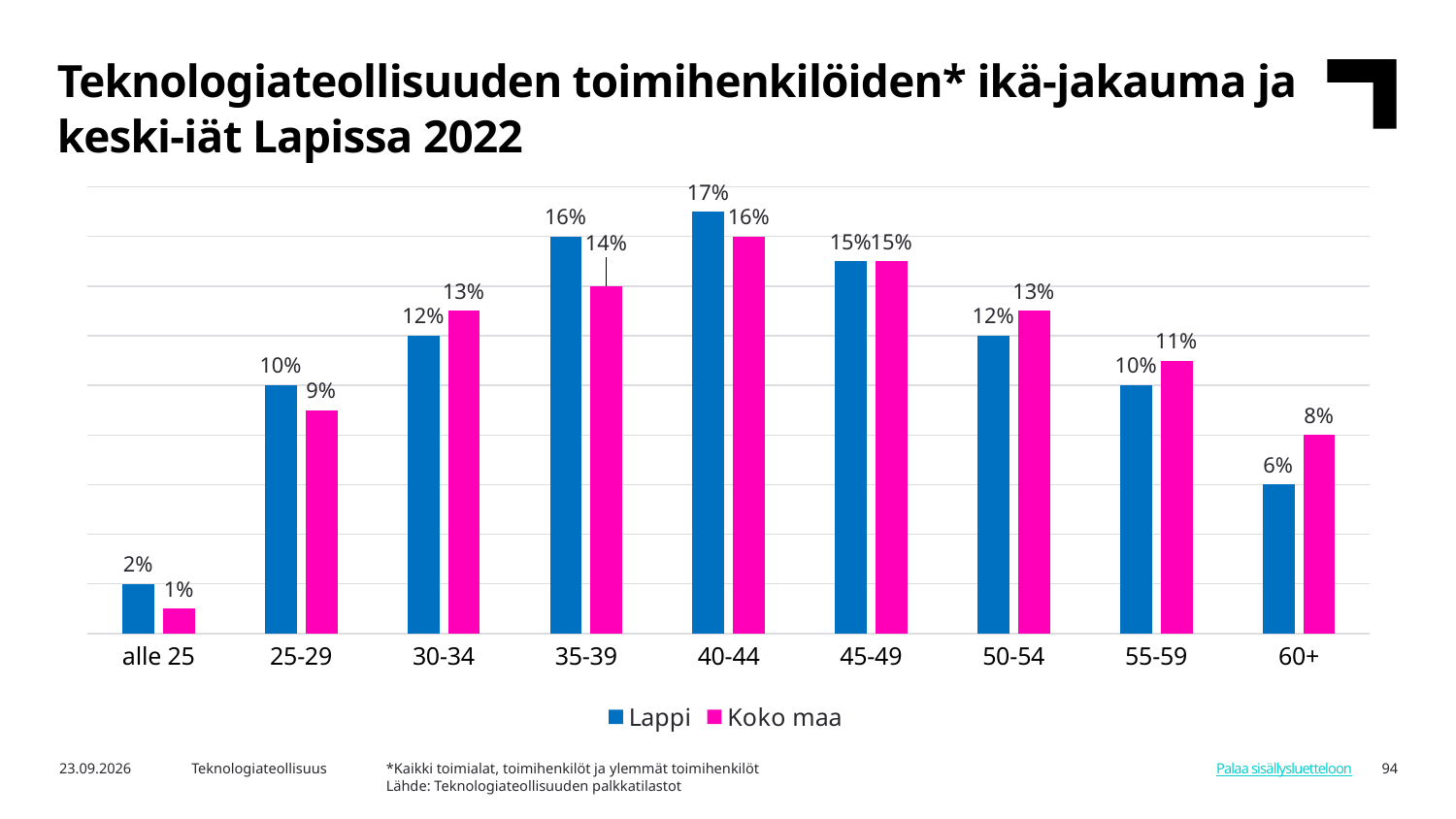
What kind of chart is shown on the slide? Bar chart What is the value for Lappi in the alle 25 age group? 2% How many series does the legend list? 2 Which age group has the lowest value for Koko maa? alle 25 What is the value for Koko maa in the 60+ age group? 8% Which age group has the highest value for Lappi? 40-44 Which series is shown in pink? Koko maa What is the difference between Lappi and Koko maa in the 60+ age group? 2% Which is larger in the 30-34 age group, Lappi or Koko maa? Koko maa What is the value for Lappi in the 40-44 age group? 17% Which is larger in the 35-39 age group, Lappi or Koko maa? Lappi How many age groups are shown on the x axis? 9